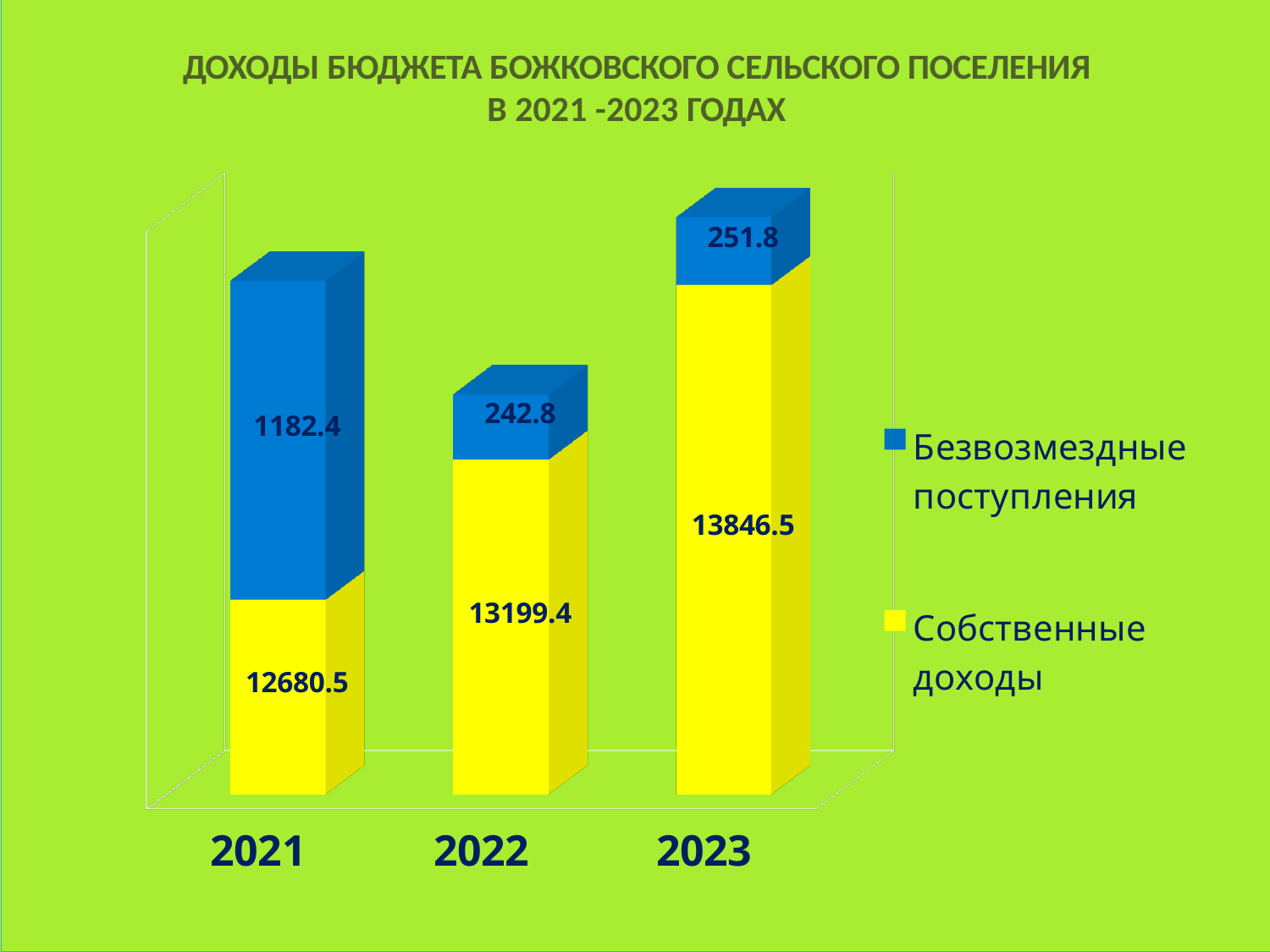
What is the value of Собственные доходы for 2023? 13846.5 What is the difference between Собственные доходы in 2023 and in 2022? 647.1 How many series does the legend list? 2 In which year is Безвозмездные поступления the lowest? 2022 What is the value of Собственные доходы for 2021? 12680.5 What is the value of Безвозмездные поступления for 2021? 1182.4 Do the values of Собственные доходы rise or fall from 2021 to 2023? rise What is the value of Безвозмездные поступления for 2022? 242.8 What is the total of the stacked bar for 2023? 14098.3 What is the difference between Безвозмездные поступления in 2021 and in 2022? 939.6 In which year is Собственные доходы the highest? 2023 Which is larger: Собственные доходы in 2022 or in 2021? 2022